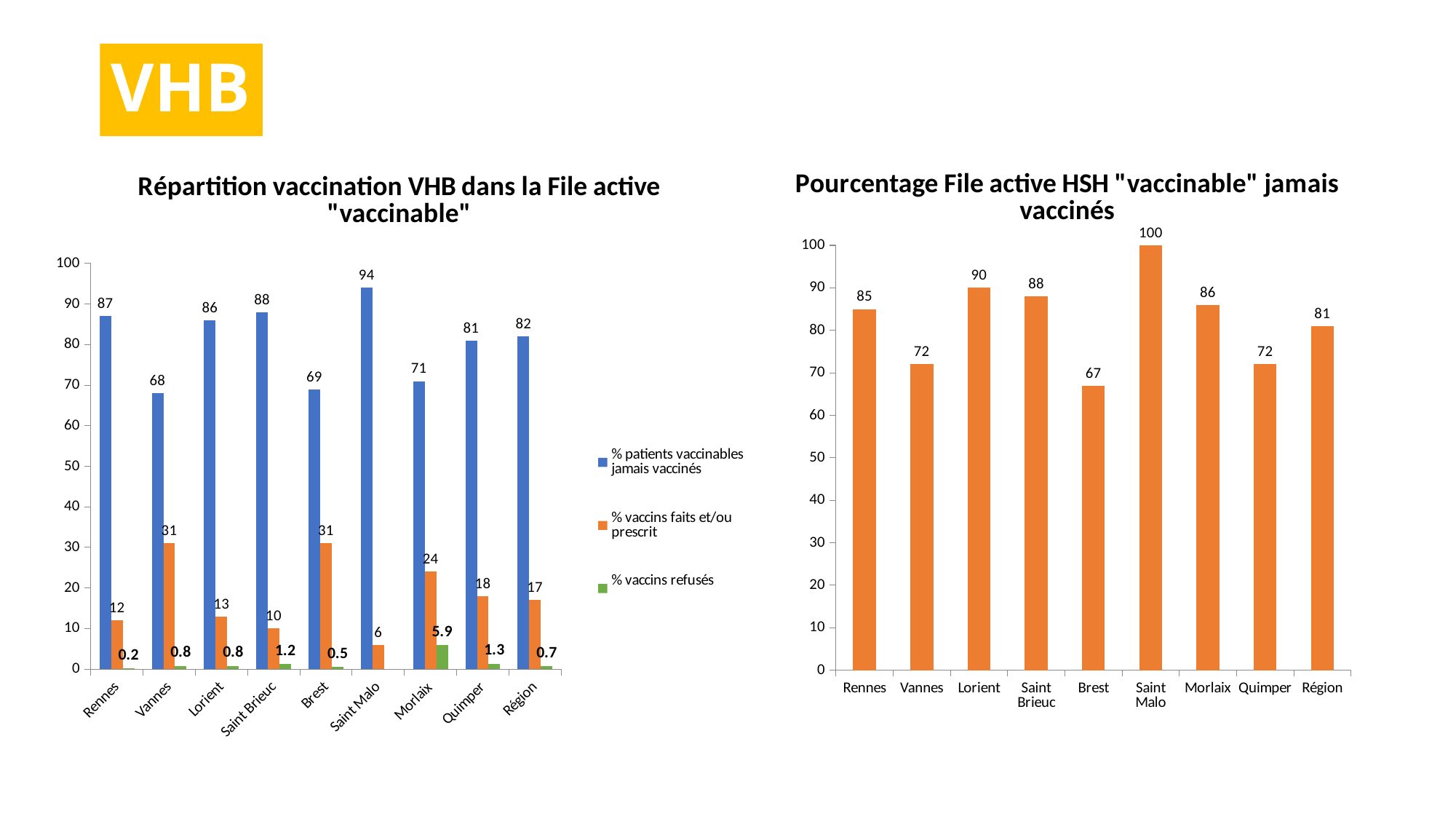
In the left chart "Répartition vaccination VHB dans la File active "vaccinable"", which category has the lowest value for "% patients vaccinables jamais vaccinés"? Vannes In the left chart "Répartition vaccination VHB dans la File active "vaccinable"", how many series does the legend list? 3 In the left chart "Répartition vaccination VHB dans la File active "vaccinable"", which category has the highest value for "% vaccins refusés"? Morlaix What kind of chart is the right chart "Pourcentage File active HSH "vaccinable" jamais vaccinés"? Bar chart In the right chart "Pourcentage File active HSH "vaccinable" jamais vaccinés", how many categories are shown on the x axis? 9 In the right chart "Pourcentage File active HSH "vaccinable" jamais vaccinés", which is larger, the value for Lorient or the value for Morlaix? Lorient In the right chart "Pourcentage File active HSH "vaccinable" jamais vaccinés", what is the value for Brest? 67 In the left chart "Répartition vaccination VHB dans la File active "vaccinable"", what is the value of "% patients vaccinables jamais vaccinés" for Saint Malo? 94 In the right chart "Pourcentage File active HSH "vaccinable" jamais vaccinés", which category has the highest value? Saint Malo In the left chart "Répartition vaccination VHB dans la File active "vaccinable"", what is the value of "% vaccins faits et/ou prescrit" for Morlaix? 24 In the left chart "Répartition vaccination VHB dans la File active "vaccinable"", what is the value of "% vaccins refusés" for Saint Brieuc? 1.2 In the left chart "Répartition vaccination VHB dans la File active "vaccinable"", what is the difference between the "% vaccins faits et/ou prescrit" values for Vannes and Rennes? 19